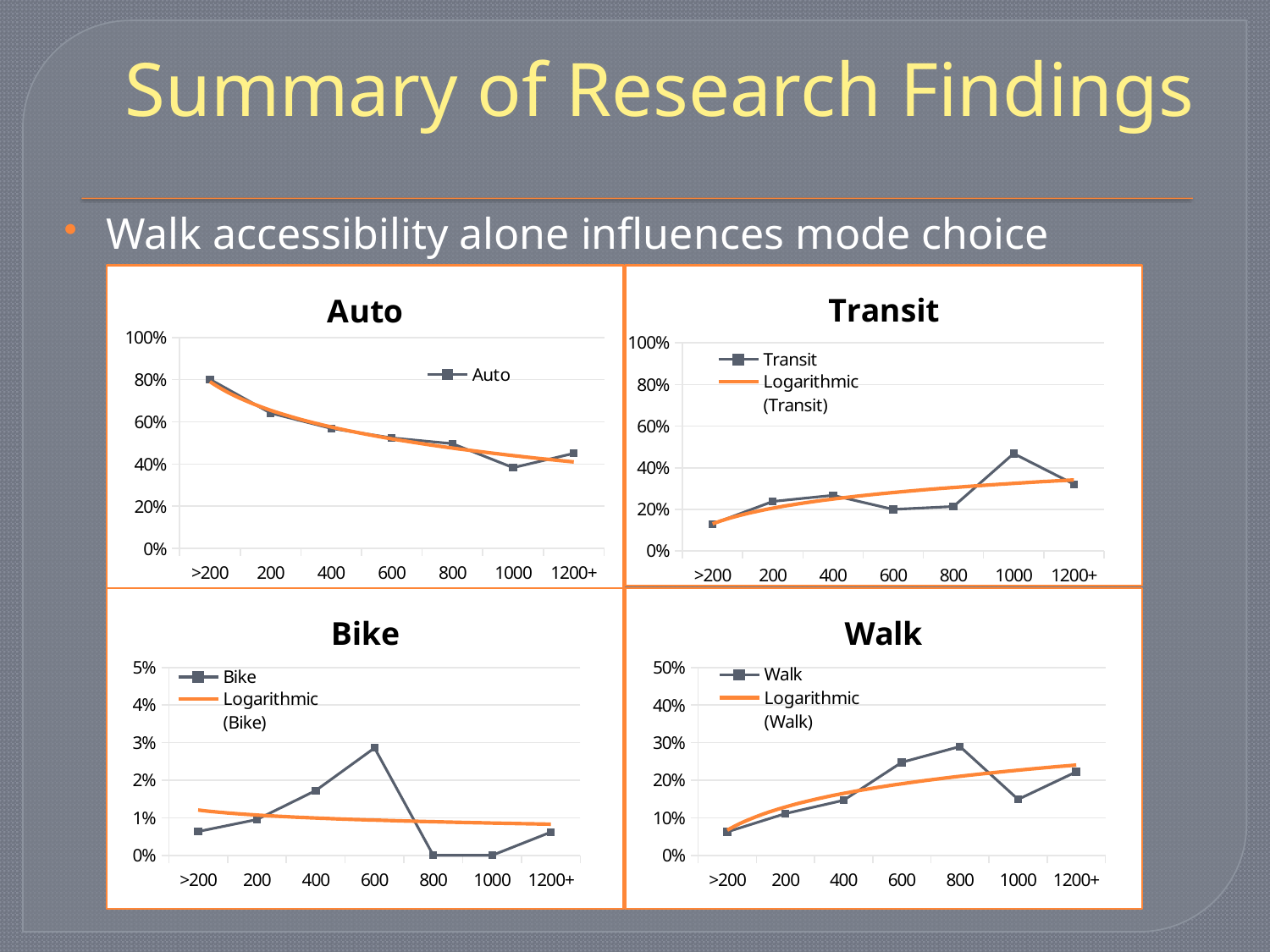
In the Auto chart, do the Auto values generally rise or fall along the x axis? fall What kind of chart is the Auto chart? line chart How many categories are shown on the x axis of the Transit chart? 7 In the Bike chart, which category has the highest Bike value? 600 How many series does the legend of the Auto chart list? 1 How many series does the legend of the Transit chart list? 2 In the Bike chart, is the Bike value for 600 greater or less than 2%? greater In the Transit chart, is the Transit value for 1000 greater or less than 40%? greater In the Transit chart, which category has the highest Transit value? 1000 In the Walk chart, which category has the lowest Walk value? >200 In the Auto chart, which category has the highest Auto value? >200 In the Walk chart, which is larger, the Walk value for 600 or for 1000? 600